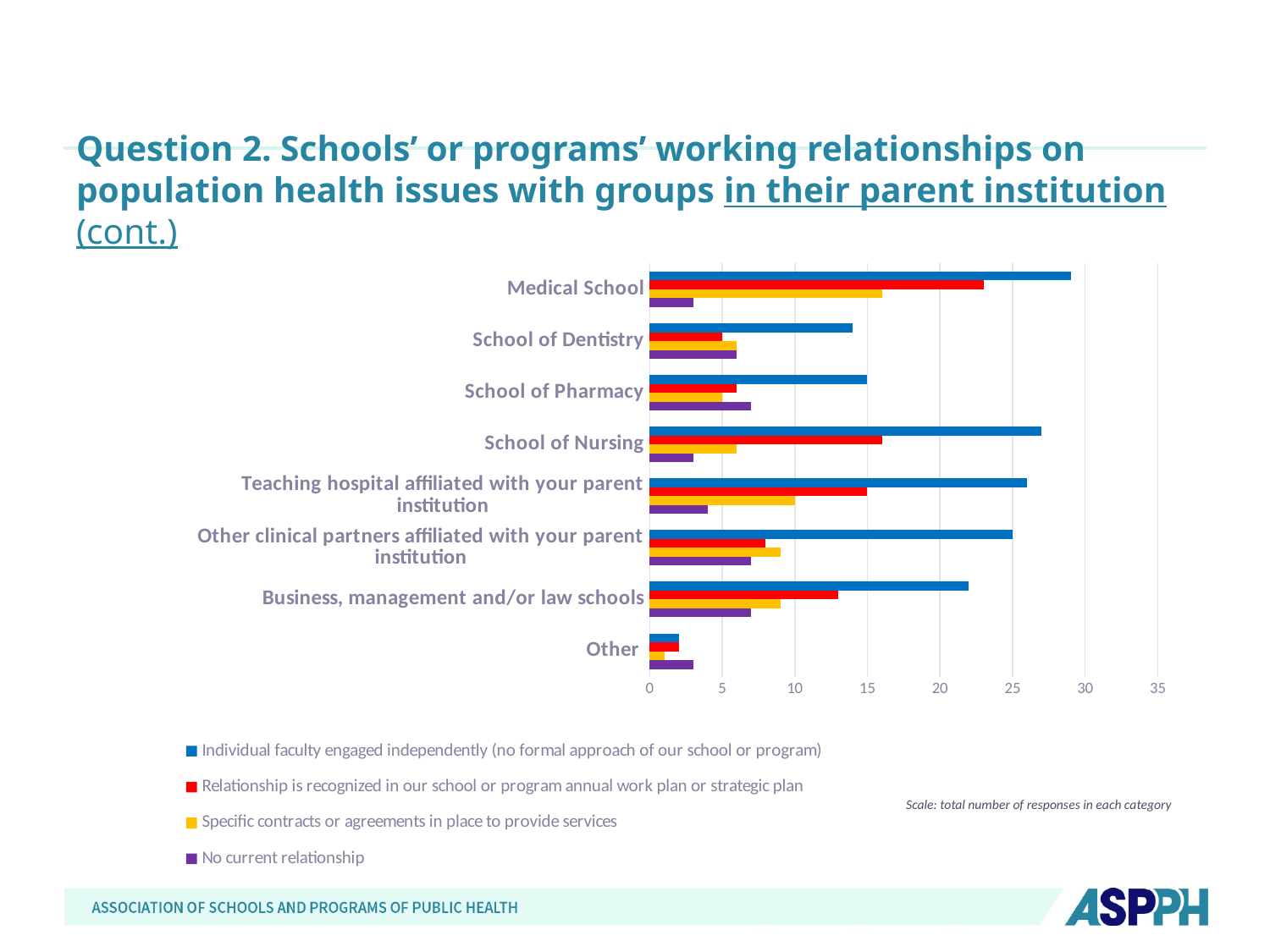
Is the value for Medical School in the 'Individual faculty engaged independently' series greater or less than 25? greater Which colour represents the 'No current relationship' series in the legend? purple Which is larger for the 'Relationship is recognized in our school or program annual work plan or strategic plan' series: School of Nursing or School of Pharmacy? School of Nursing How many series does the legend list? 4 Is the value for Other in the 'Individual faculty engaged independently' series greater or less than 5? less How many categories (groups in the parent institution) are shown on the chart? 8 Which category has the highest value for 'Relationship is recognized in our school or program annual work plan or strategic plan'? Medical School Is the value for School of Dentistry in the 'Individual faculty engaged independently' series greater or less than 10? greater What kind of chart is shown on the slide? bar chart Which category has the highest value for 'Individual faculty engaged independently (no formal approach of our school or program)'? Medical School Which category has the lowest value for 'Individual faculty engaged independently (no formal approach of our school or program)'? Other